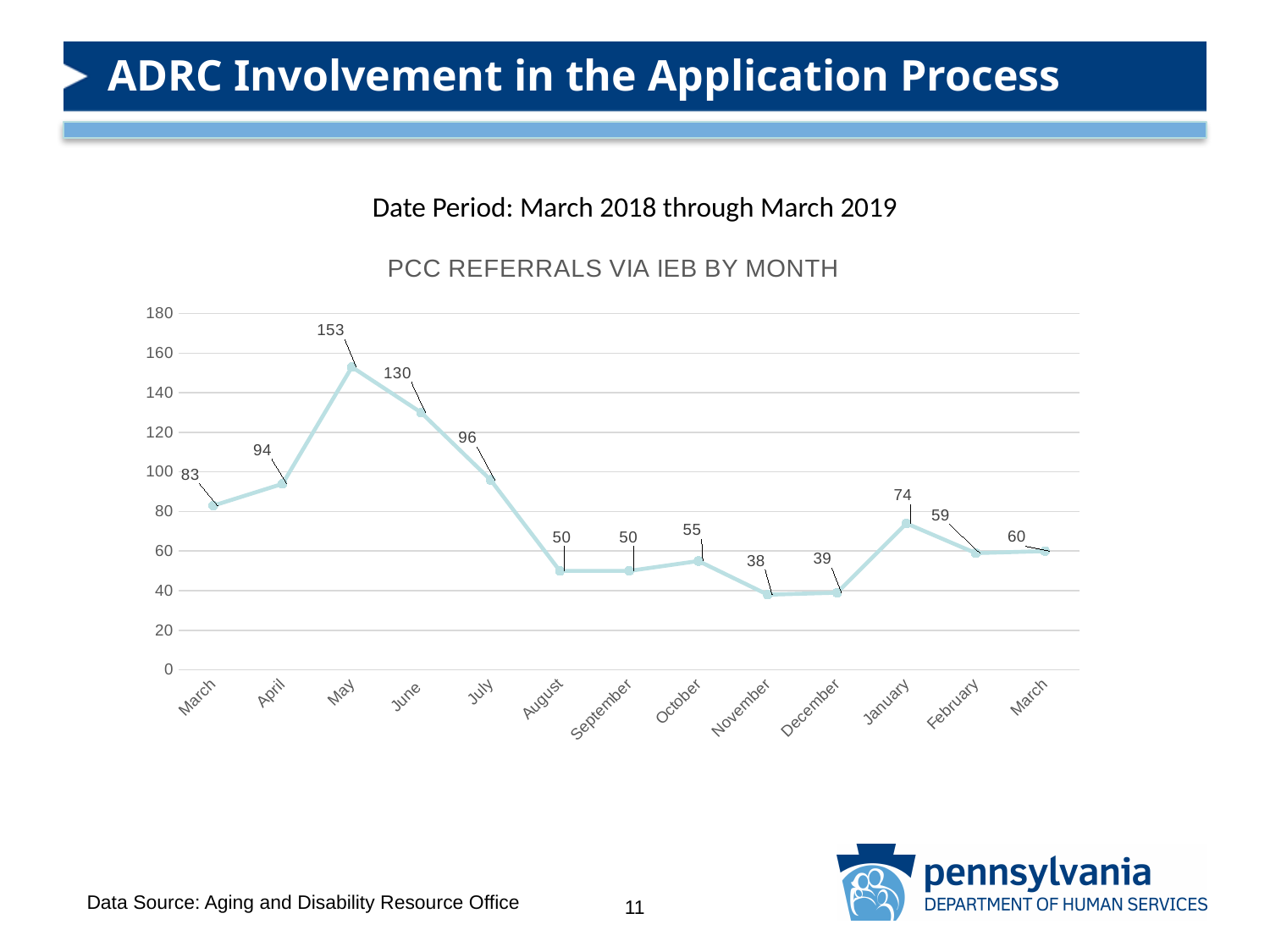
Which month has the lowest value? November What is the difference between the values for May and June? 23 Which month has the highest value? May How many data points are plotted on the chart? 13 Do the values rise or fall from May to August? fall What is the value for May? 153 What is the value for the first March point (March 2018)? 83 What is the title of the chart? PCC REFERRALS VIA IEB BY MONTH What is the value for the last March point (March 2019)? 60 Which is larger, the value for January or the value for February? January What type of chart is shown on the slide? line chart What is the value for November? 38